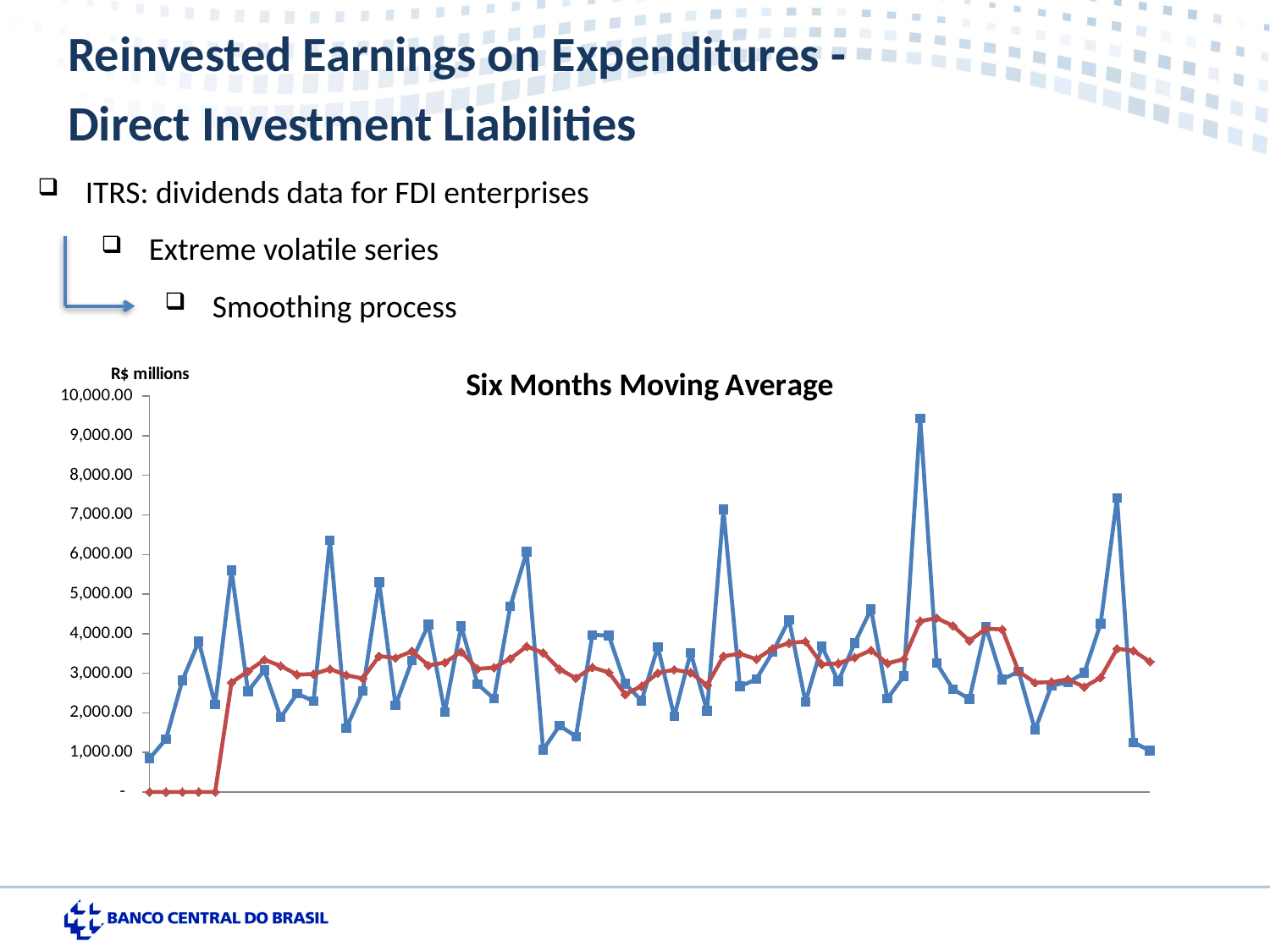
What unit is shown on the vertical axis of the chart? R$ millions Is the highest point of the blue line greater or less than 9,000.00? greater Is the first point of the blue line greater or less than 2,000.00? less What type of chart is shown on the slide? line chart Is the highest point of the red line greater or less than 5,000.00? less What is the highest value shown on the vertical axis? 10,000.00 Which line reaches the higher peak, the blue line or the red line? the blue line What is the title of the chart? Six Months Moving Average How many lines are plotted on the chart? 2